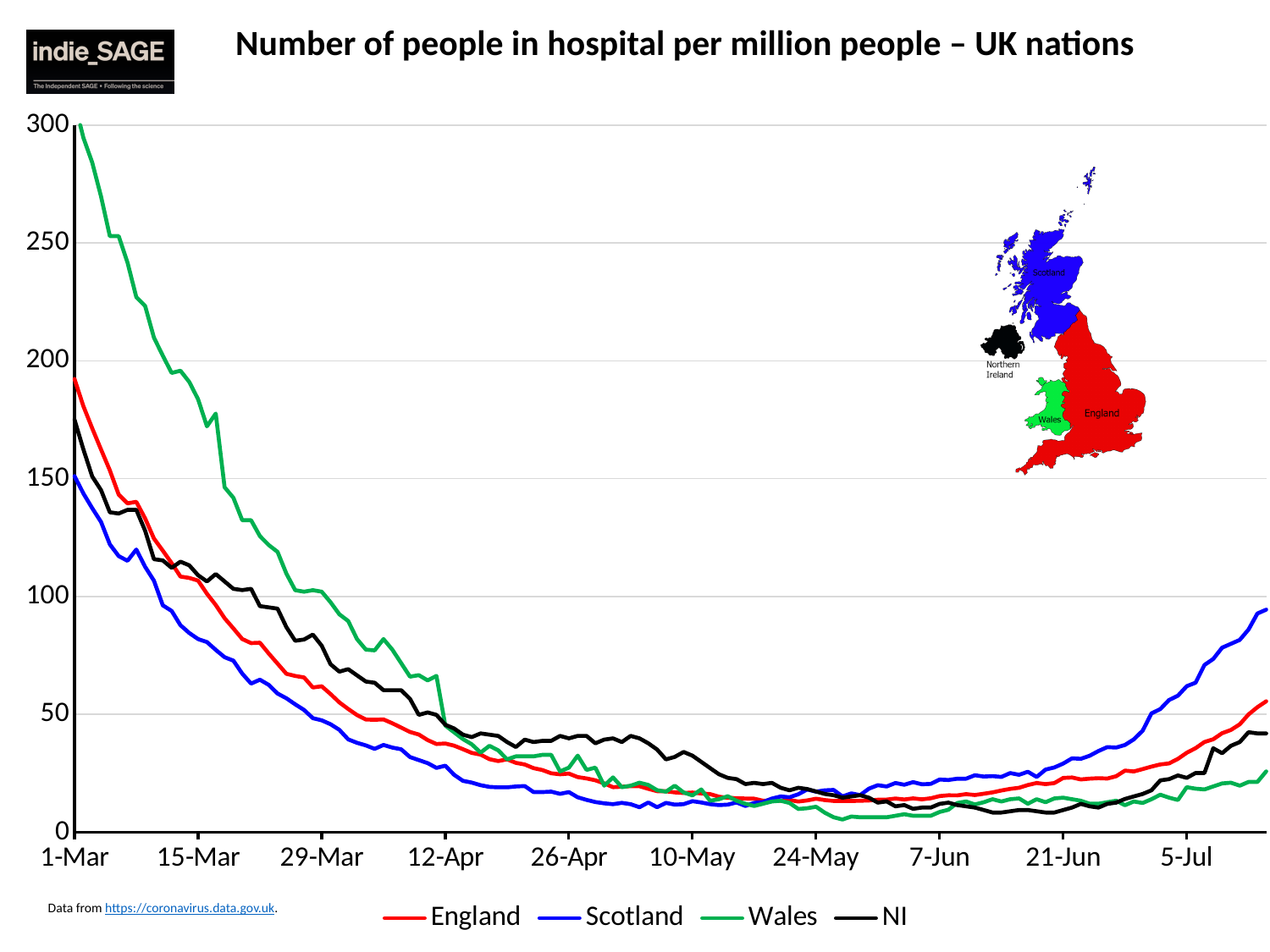
How many series does the legend list? 4 What is the title of the chart? Number of people in hospital per million people – UK nations At the right-hand end of the chart, which is higher, Scotland or Wales? Scotland Is the value for Scotland at the right-hand end of the chart greater or less than 50? greater Is the value for Wales on 1-Mar greater or less than 250? greater Do the values for Wales rise or fall between 1-Mar and 24-May? fall What colour is the line for Wales? green What kind of chart is shown on the slide? line chart Which nation has the highest value on 1-Mar? Wales Which nation has the lowest value on 1-Mar? Scotland Is the value for England on 1-Mar greater or less than 150? greater Which nation has the highest value at the right-hand end of the chart? Scotland